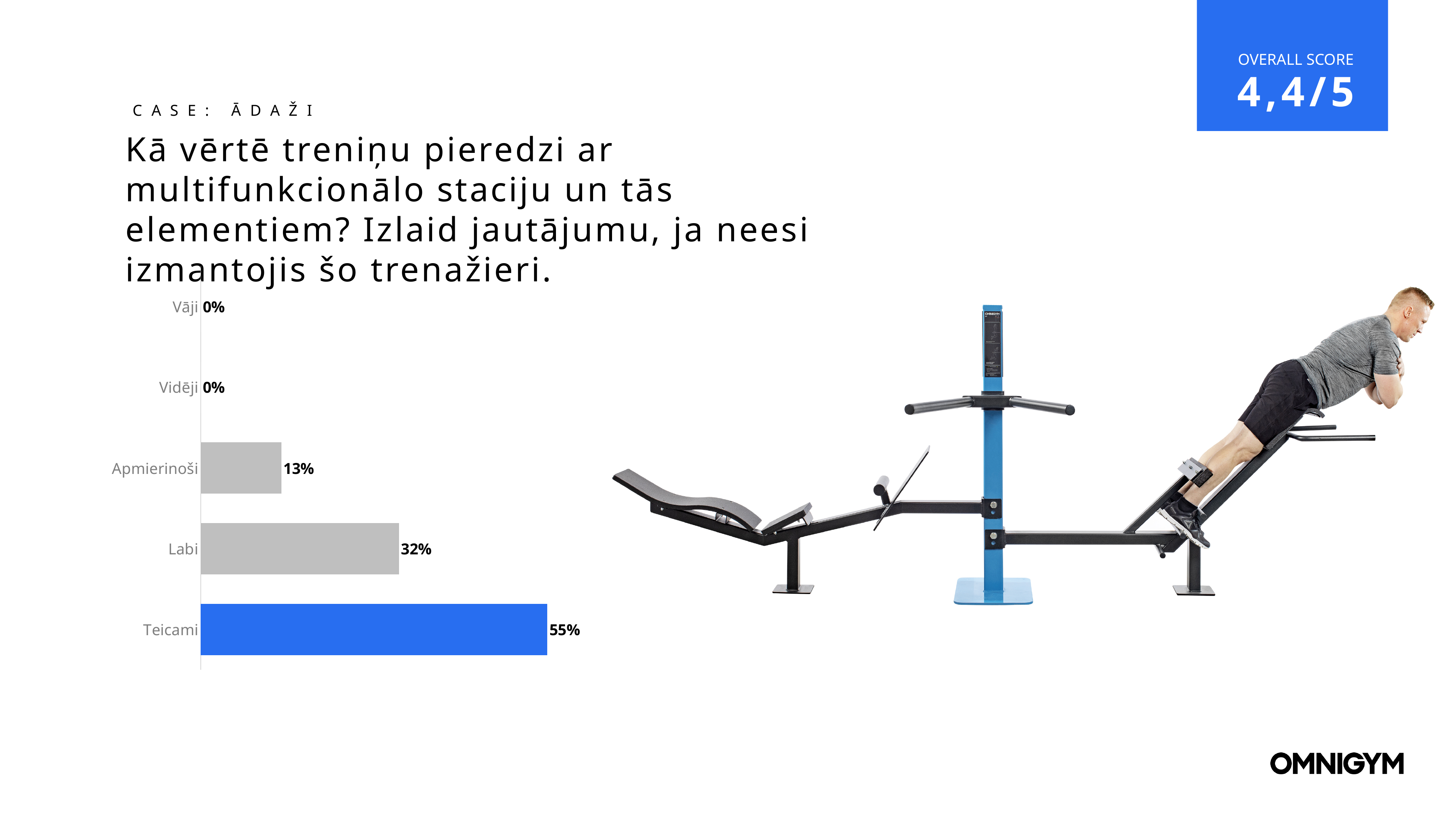
What kind of chart is shown on the slide? Bar chart What is the value for Teicami? 55% Which bar in the chart is coloured blue? Teicami What is the value for Labi? 32% What is the value for Apmierinoši? 13% What is the value for Vāji? 0% What is the difference between the values for Teicami and Labi? 23% Which category has the highest value? Teicami What is the combined value of Teicami and Labi? 87% What is the difference between the values for Labi and Apmierinoši? 19% How many categories are shown in the chart? 5 Which is larger, the value for Labi or the value for Apmierinoši? Labi